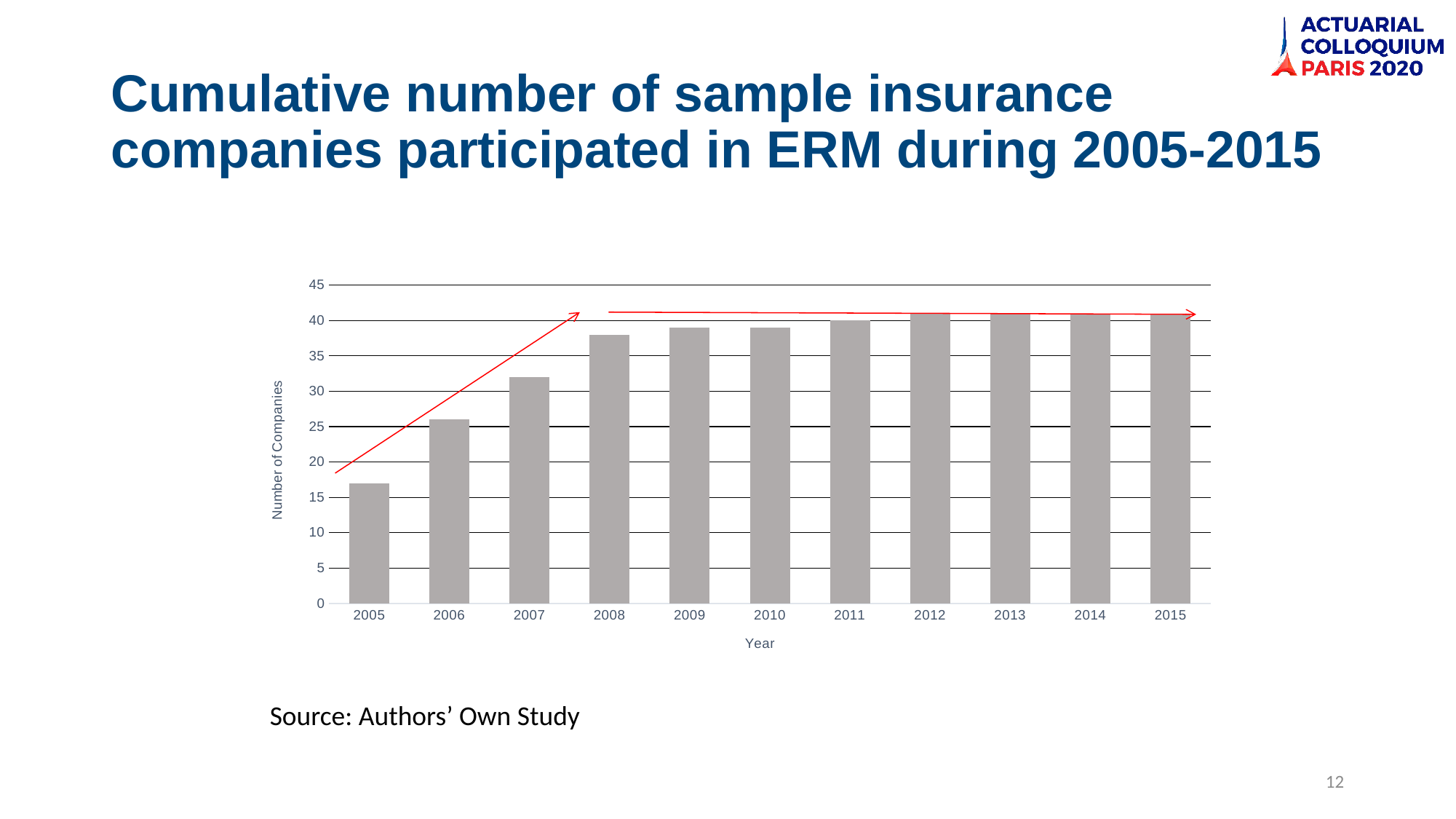
Is the value for 2005 greater or less than 20? less Which is larger, the value for 2005 or the value for 2007? 2007 Is the value for 2015 greater or less than 35? greater Is the value for 2007 greater or less than 30? greater How many years are shown on the x axis of the chart? 11 What is the label of the vertical axis? Number of Companies Do the values generally rise or fall from 2005 to 2015? rise Which year has the lowest number of companies? 2005 What is the label of the horizontal axis? Year What kind of chart is shown on the slide? bar chart